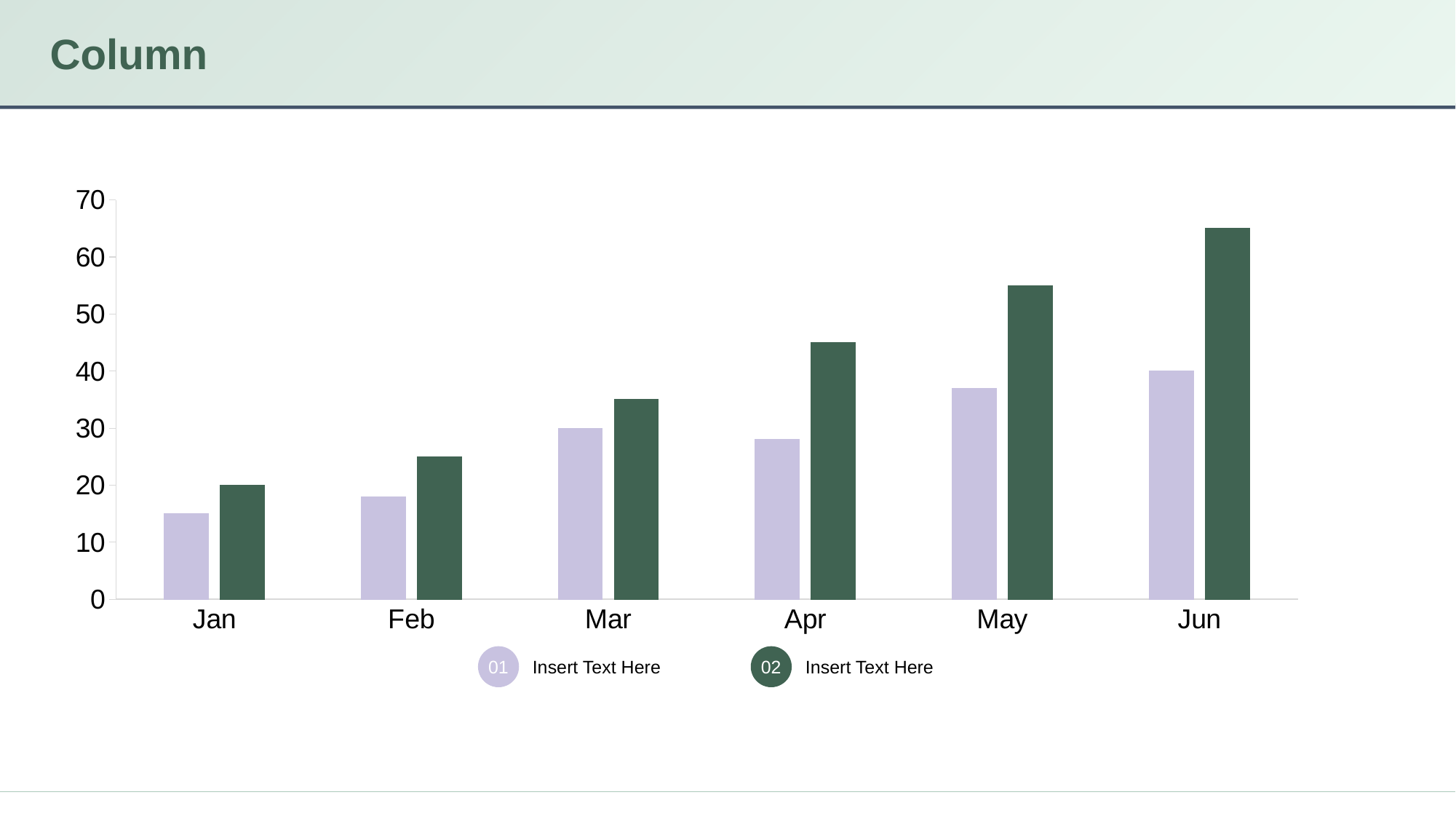
For Apr, which bar is larger, the light purple one or the dark green one? dark green How many series does the chart's legend list? 2 What kind of chart is shown on the slide? bar chart In which month is the light purple bar lowest? Jan How many months are shown on the x axis of the chart? 6 Do the dark green bars rise or fall from Jan to Jun? rise What is the value of the light purple bar for Jun? 40 What is the value of the dark green bar for Jan? 20 Is the value of the light purple bar for Feb greater or less than 20? less What is the value of the light purple bar for Mar? 30 Is the value of the dark green bar for Jun greater or less than 60? greater In which month is the dark green bar highest? Jun